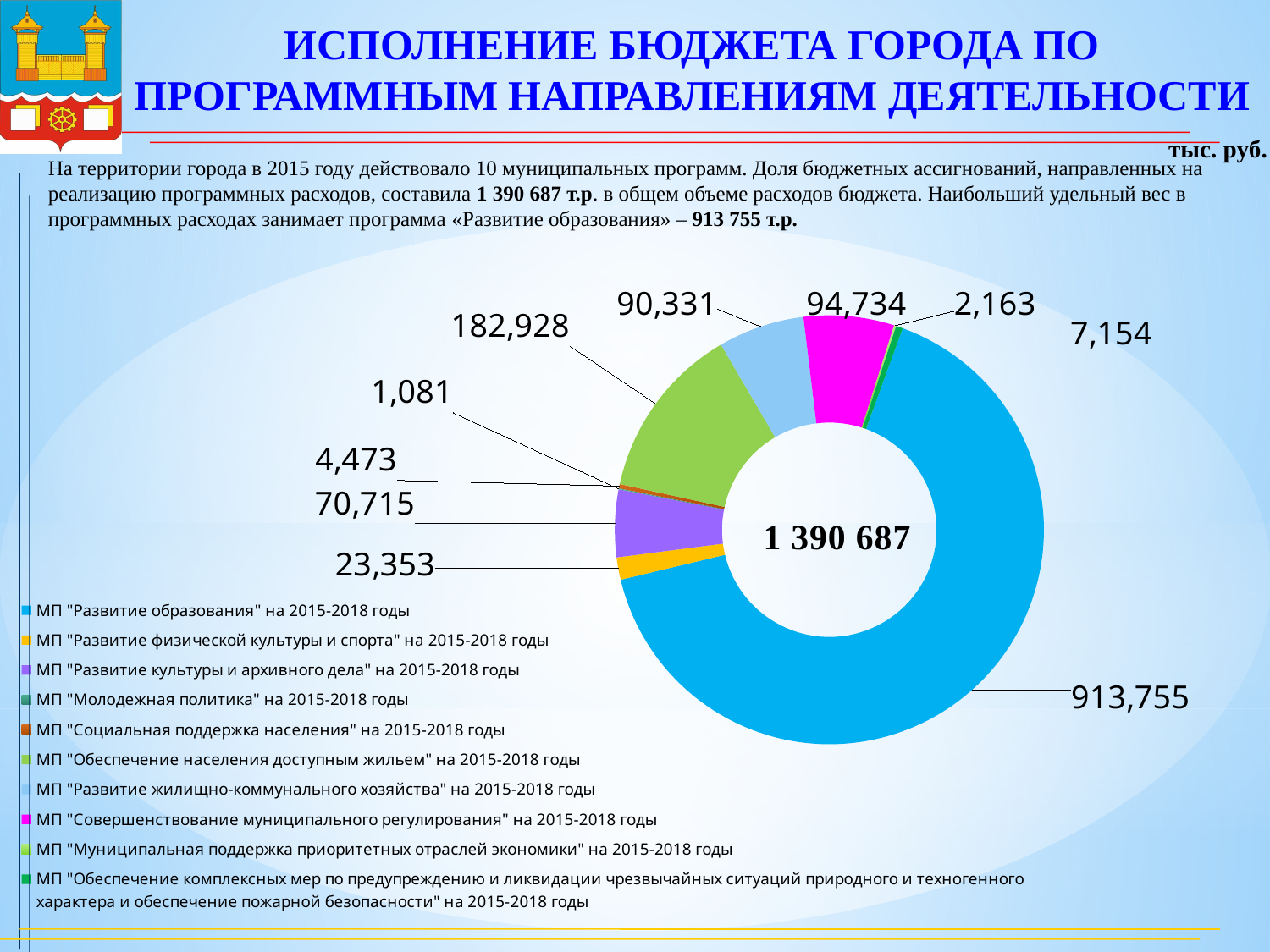
What is the value for МП "Развитие культуры и архивного дела" на 2015-2018 годы? 70,715 How many programmes (slices) does the chart show? 10 What kind of chart is shown on the slide? Donut (pie) chart What total value is printed in the centre of the donut chart? 1 390 687 What is the difference between the slices labelled 94,734 and 90,331? 4,403 Which programme has the largest slice of the chart? МП "Развитие образования" на 2015-2018 годы What is the value for МП "Обеспечение населения доступным жильем" на 2015-2018 годы? 182,928 What is the value for МП "Развитие образования" на 2015-2018 годы? 913,755 What is the value for МП "Развитие физической культуры и спорта" на 2015-2018 годы? 23,353 How many entries does the legend list? 10 Which is larger: the slice for МП "Обеспечение населения доступным жильем" or the slice for МП "Развитие культуры и архивного дела"? МП "Обеспечение населения доступным жильем" What is the smallest value labelled on the chart? 1,081